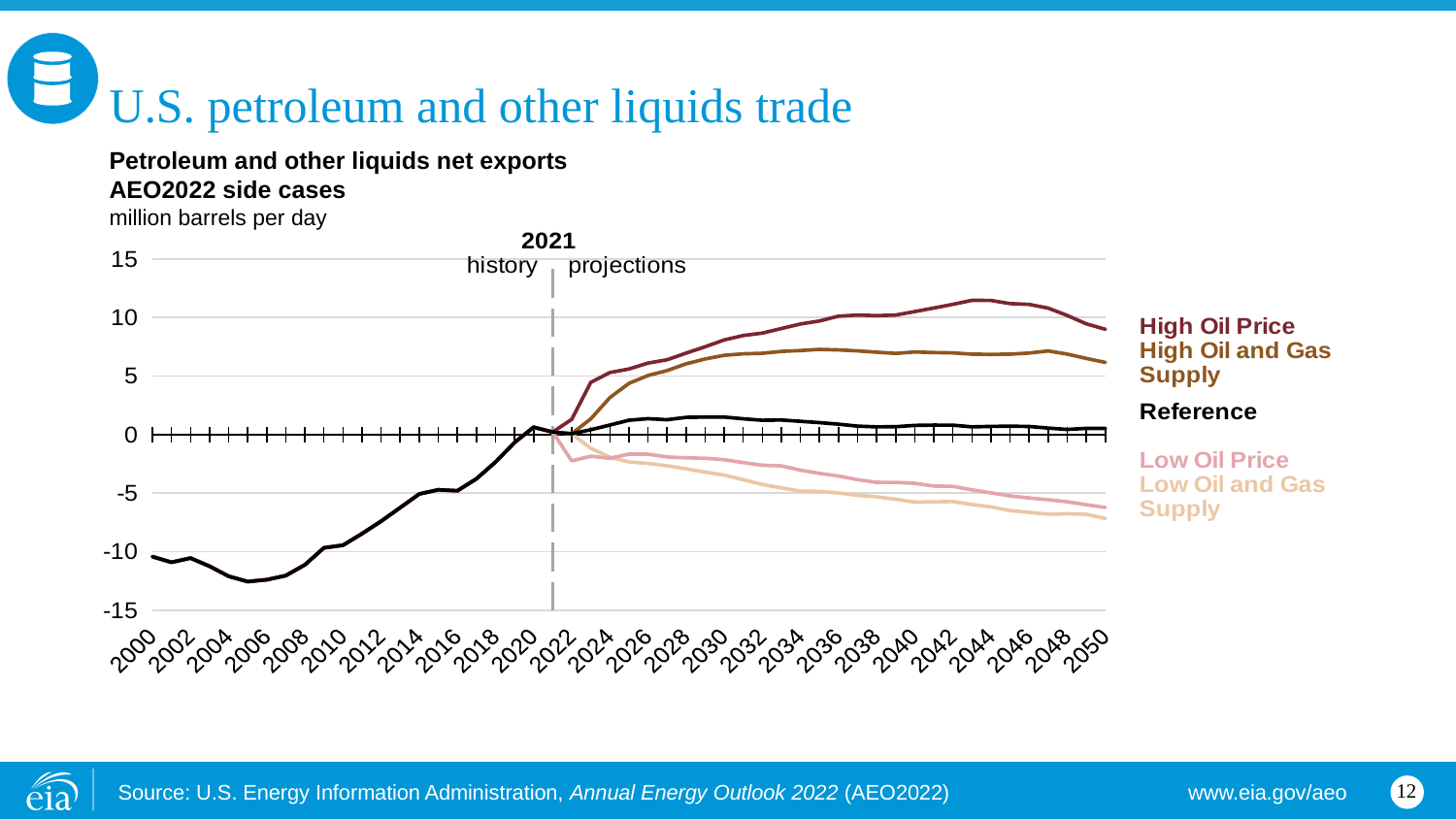
Which case has the highest net exports in 2050? High Oil Price What kind of chart is shown on the slide? line chart Is the Low Oil and Gas Supply value in 2050 greater or less than -5? less Which case has the lowest net exports in 2050? Low Oil and Gas Supply Is the High Oil Price value in 2044 greater or less than 10? greater How many series (cases) does the legend list? 5 Do historical net exports rise or fall from 2005 to 2021? rise Is the historical net exports value in 2005 greater or less than -10? less In 2050, which is larger: the High Oil Price case or the High Oil and Gas Supply case? High Oil Price Does the Low Oil and Gas Supply case rise or fall from 2022 to 2050? fall What unit is the y axis measured in? million barrels per day